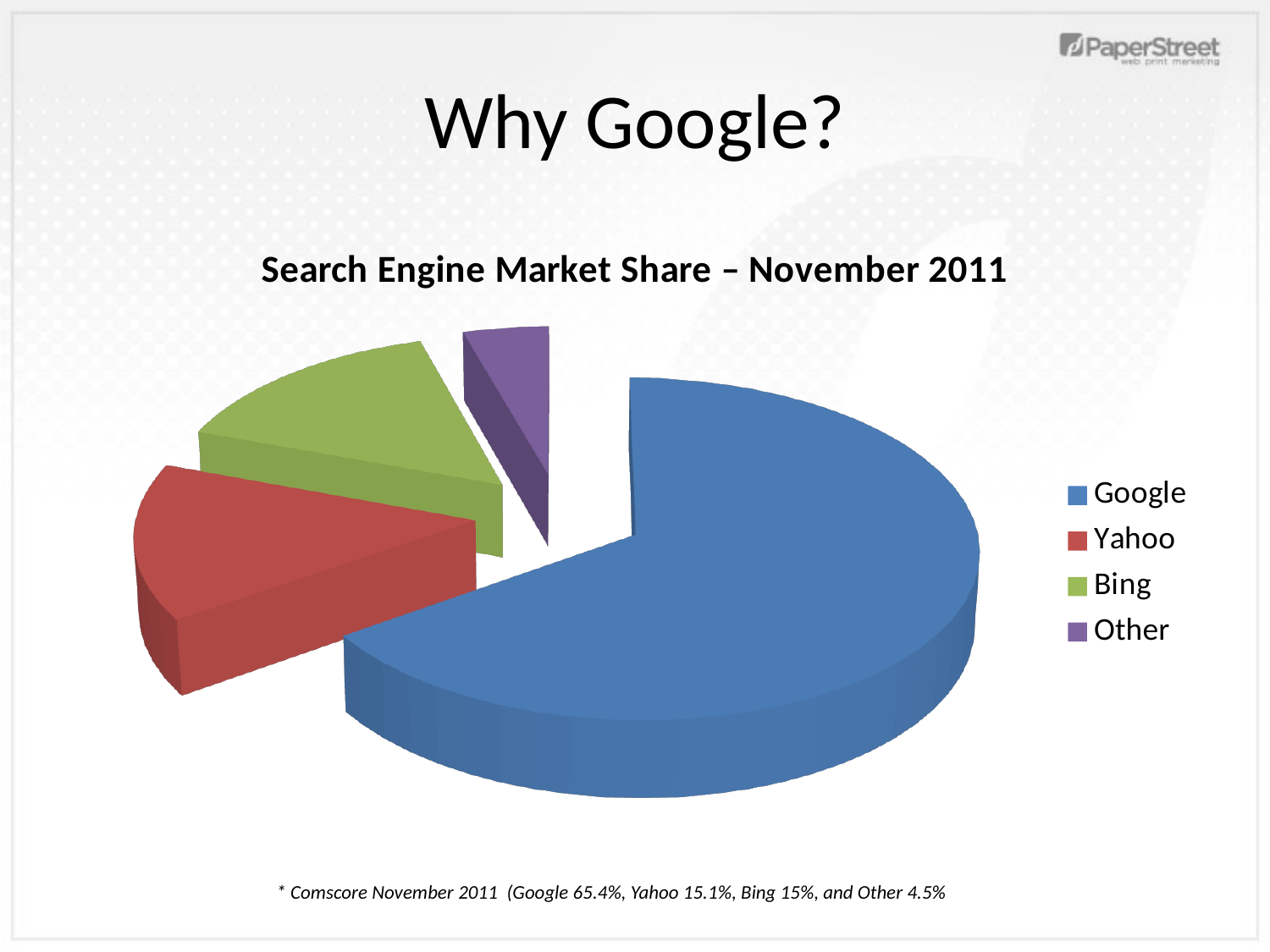
What is the difference between Google's and Bing's market share? 50.4% What is Yahoo's market share according to the slide? 15.1% Which colour represents Bing in the legend? green What is Google's market share according to the slide? 65.4% What kind of chart is shown on the slide? pie chart What is Bing's market share according to the slide? 15% How many search engine categories does the pie chart show? 4 What is the market share of the Other category? 4.5% Which search engine has the largest share of the pie? Google What is the title of the chart? Search Engine Market Share – November 2011 Which category has the smallest slice of the pie? Other Is Google's slice larger or smaller than Yahoo's slice? larger